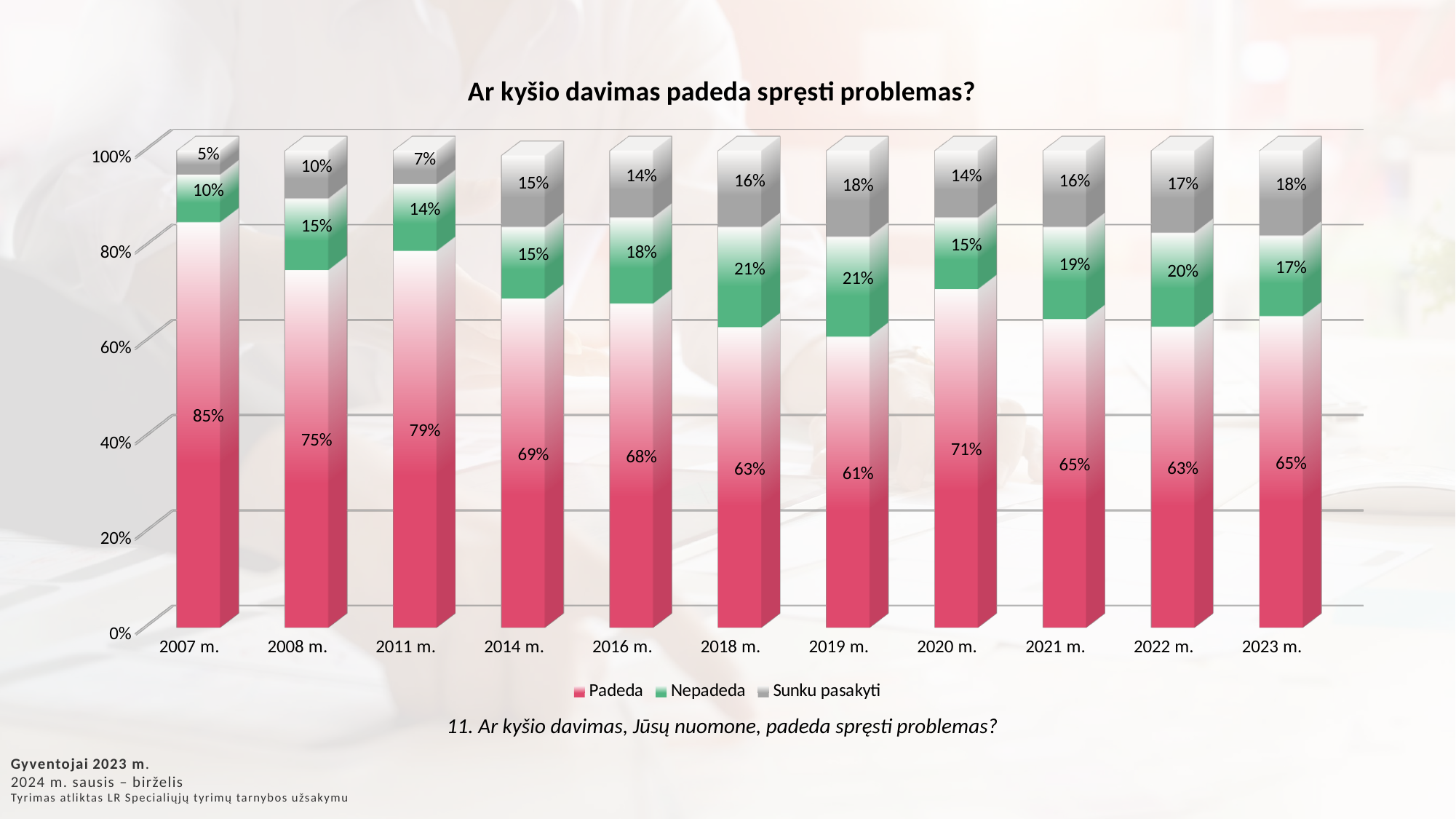
Which series is shown in green in the legend? Nepadeda How many series does the legend list? 3 How many years are shown on the x axis? 11 What is the difference between the Padeda value in 2007 m. and in 2023 m.? 20% What is the value for Padeda in 2007 m.? 85% What is the value for Nepadeda in 2019 m.? 21% What is the title of the chart? Ar kyšio davimas padeda spręsti problemas? In which year is the Padeda value the lowest? 2019 m. What kind of chart is shown on the slide? Stacked bar chart Which is larger, the Nepadeda value in 2018 m. or in 2020 m.? 2018 m. In which year is the Padeda value the highest? 2007 m. What is the value for Sunku pasakyti in 2023 m.? 18%